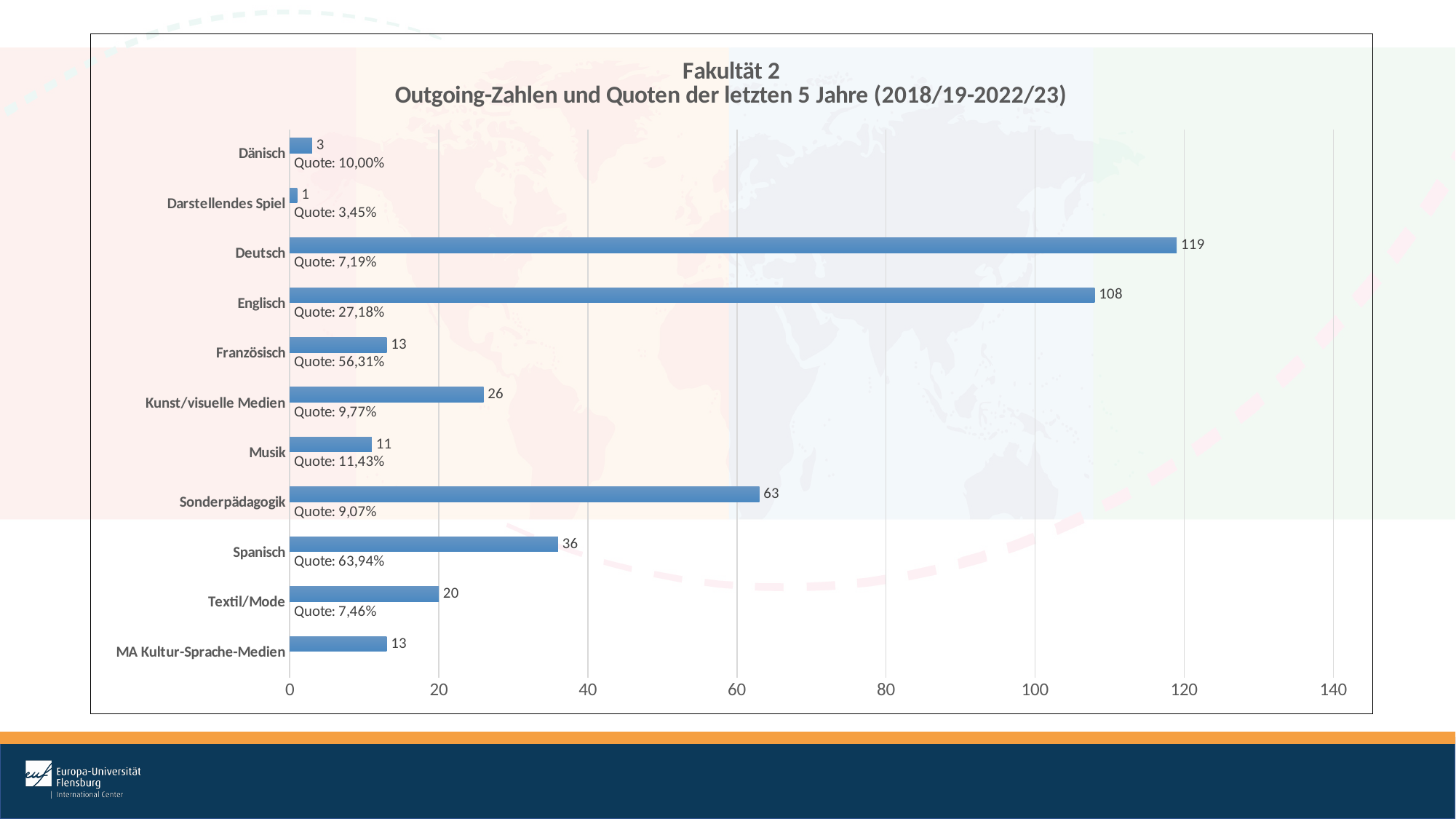
What is the Quote shown for Englisch? 27,18% What is the title of the chart? Fakultät 2 Outgoing-Zahlen und Quoten der letzten 5 Jahre (2018/19-2022/23) What is the Quote shown for Spanisch? 63,94% Which has a larger outgoing number, Spanisch or Kunst/visuelle Medien? Spanisch What kind of chart is shown on the slide? bar chart What is the difference between the outgoing numbers for Deutsch and Englisch? 11 Which category has the lowest outgoing number? Darstellendes Spiel How many categories are shown on the chart? 11 Is the value for Sonderpädagogik greater or less than 60? greater What is the outgoing number for Deutsch? 119 Which category has the highest outgoing number? Deutsch What is the outgoing number for Sonderpädagogik? 63